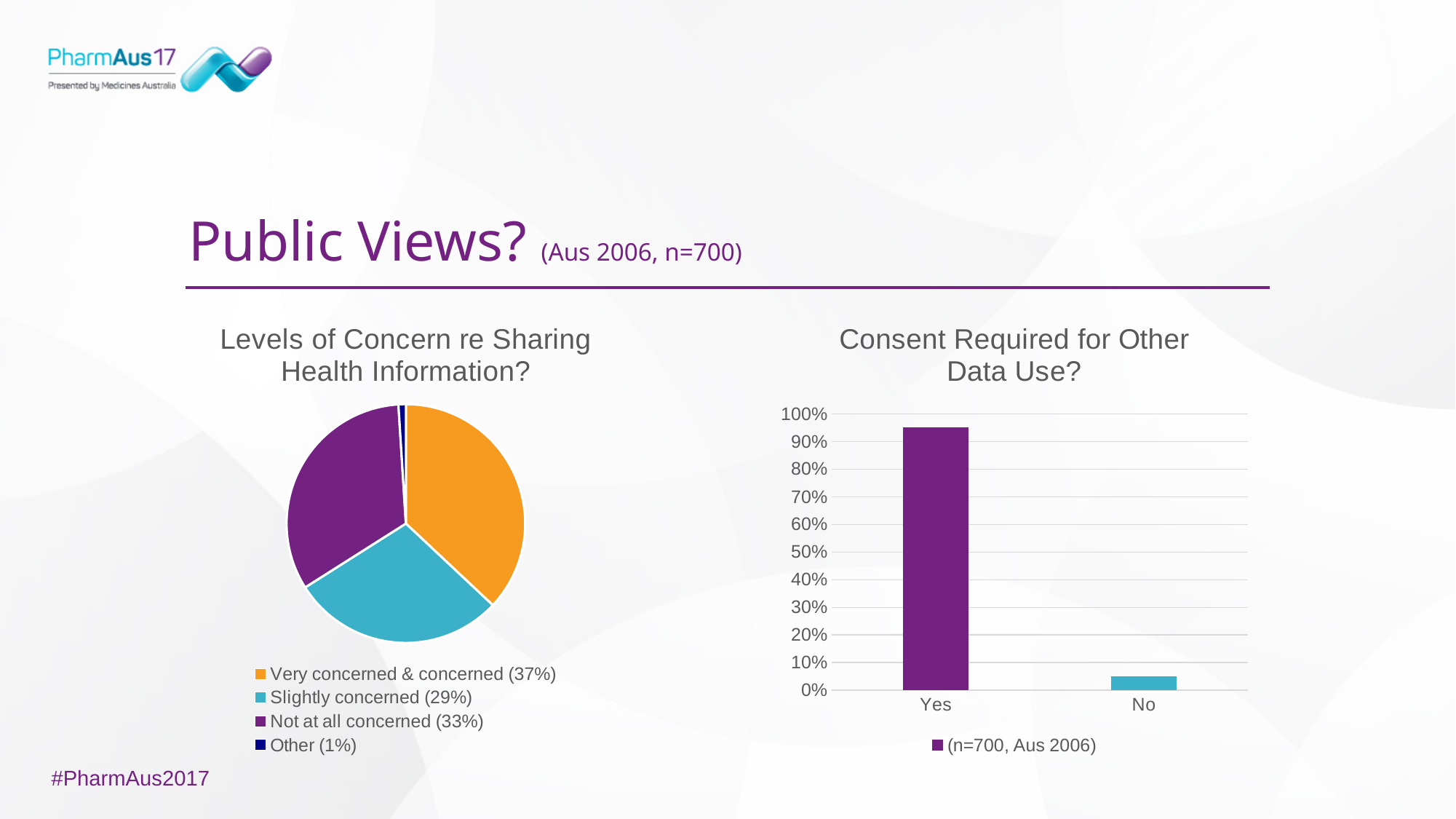
In the 'Levels of Concern re Sharing Health Information?' pie chart, what share is 'Not at all concerned'? 33% In the 'Consent Required for Other Data Use?' chart, is the value for 'No' greater or less than 10%? less In the 'Levels of Concern re Sharing Health Information?' pie chart, what share is 'Slightly concerned'? 29% What type of chart is 'Levels of Concern re Sharing Health Information?'? Pie chart In the 'Levels of Concern re Sharing Health Information?' pie chart, which category has the largest share? Very concerned & concerned (37%) In the 'Levels of Concern re Sharing Health Information?' pie chart, which category has the smallest share? Other (1%) What type of chart is 'Consent Required for Other Data Use?'? Bar chart In the 'Levels of Concern re Sharing Health Information?' pie chart, how many categories are shown in the legend? 4 In the 'Consent Required for Other Data Use?' chart, is the value for 'Yes' greater or less than 90%? greater In the 'Levels of Concern re Sharing Health Information?' pie chart, what is the difference between the 'Very concerned & concerned' share and the 'Slightly concerned' share? 8% In the 'Consent Required for Other Data Use?' chart, what is the legend entry? (n=700, Aus 2006) In the 'Consent Required for Other Data Use?' chart, which category has the higher value, 'Yes' or 'No'? Yes